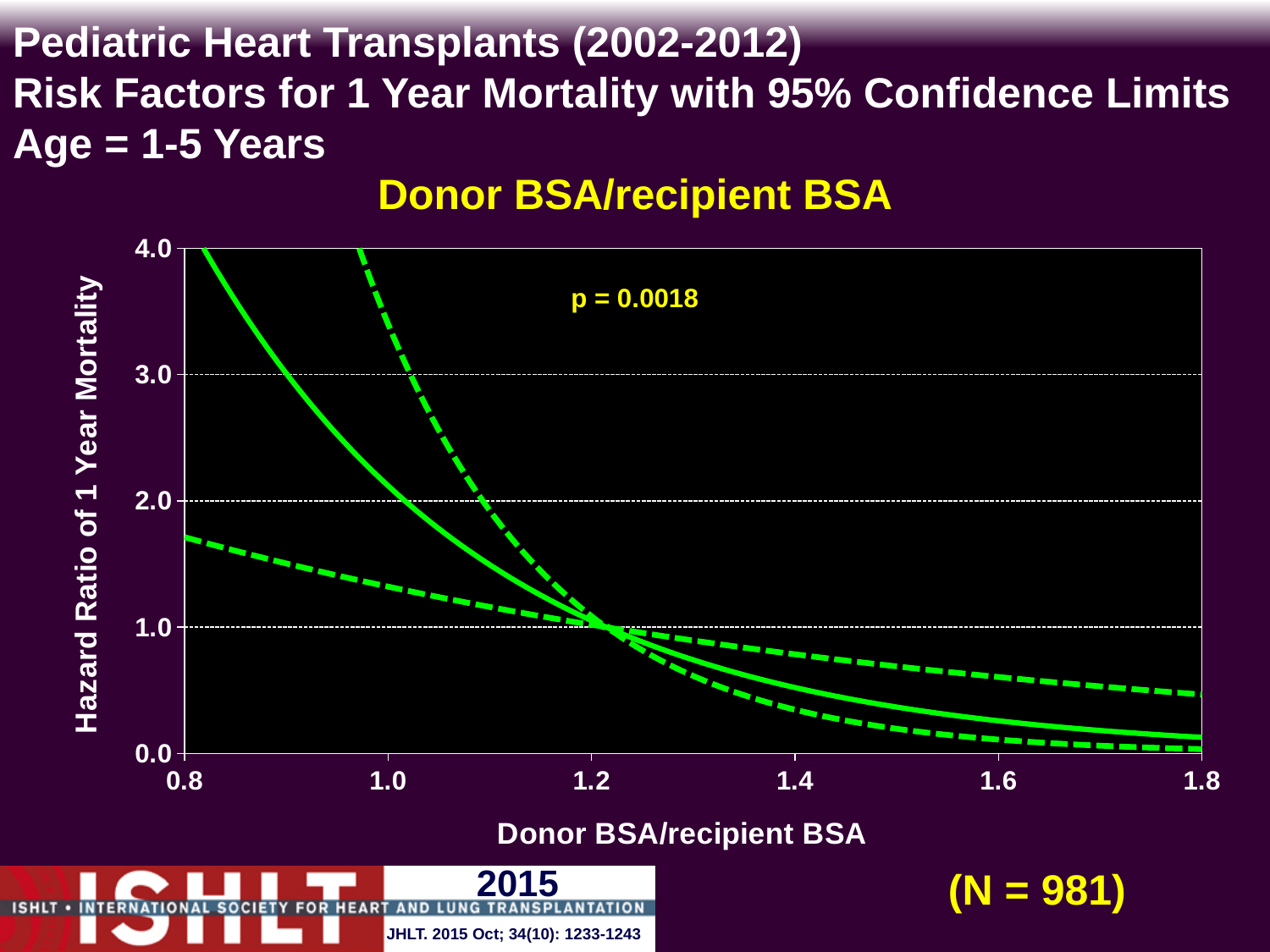
What p-value is printed on the chart? p = 0.0018 What is the label of the y axis? Hazard Ratio of 1 Year Mortality Is the value of the solid hazard ratio line at a Donor BSA/recipient BSA of 1.6 greater or less than 1.0? less Does the solid hazard ratio line rise or fall as Donor BSA/recipient BSA increases along the x axis? fall Is the value of the lower dashed confidence limit at a Donor BSA/recipient BSA of 0.8 greater or less than 1.0? greater Is the value of the upper dashed confidence limit at a Donor BSA/recipient BSA of 1.8 greater or less than 1.0? less What is the title of the chart? Donor BSA/recipient BSA At a Donor BSA/recipient BSA of 1.0, which is larger: the solid hazard ratio line or the lower dashed confidence limit? the solid hazard ratio line What kind of chart is shown on the slide? line chart What is the highest value shown on the y axis? 4.0